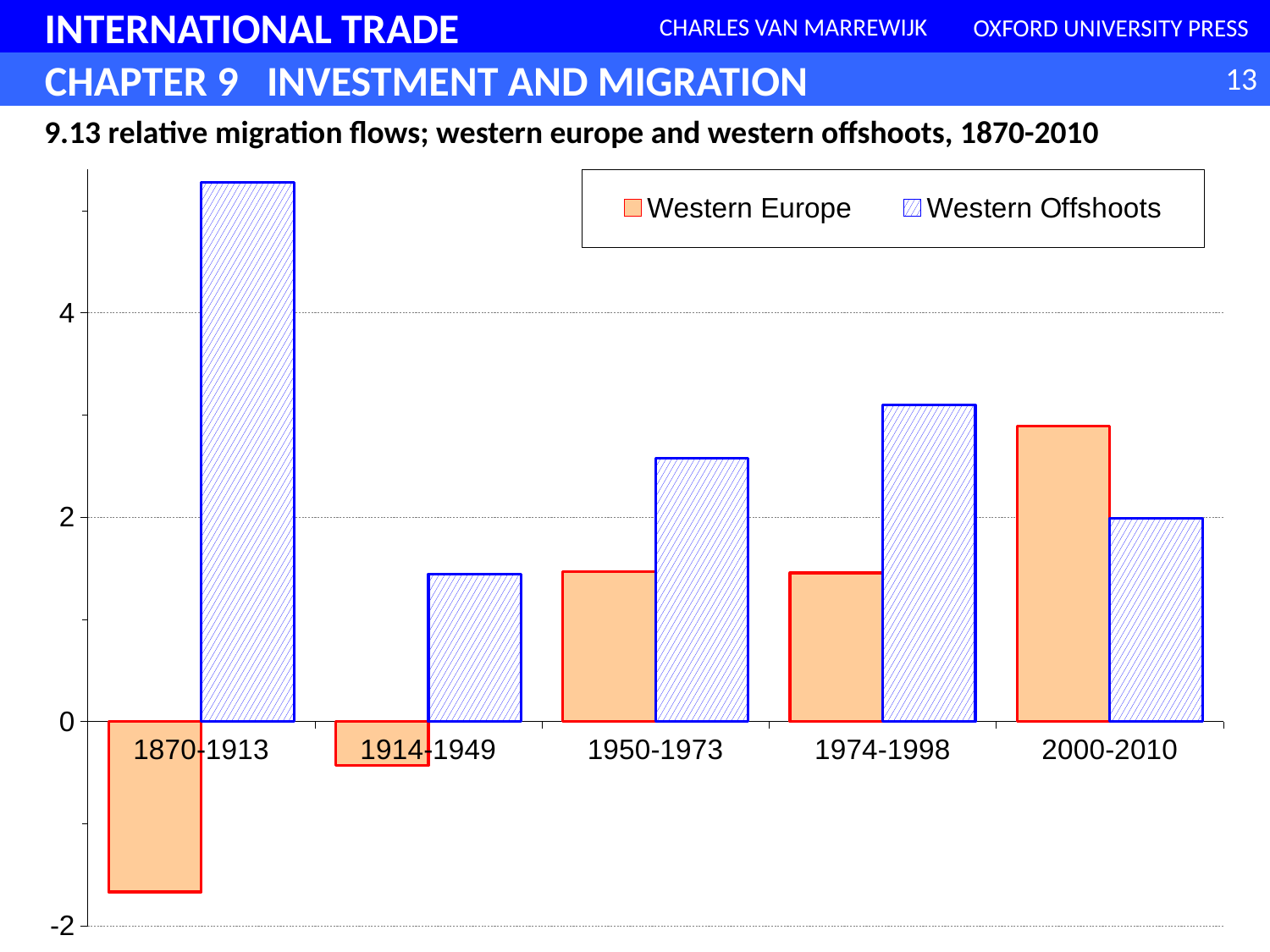
How many series does the legend list? 2 In which period is the Western Europe value lowest? 1870-1913 In which period is the Western Offshoots value highest? 1870-1913 Is the Western Europe value for 1870-1913 greater or less than 0? less What is the title of the chart? 9.13 relative migration flows; western europe and western offshoots, 1870-2010 Is the Western Offshoots value for 1974-1998 greater or less than 2? greater What kind of chart is shown on the slide? bar chart In 1870-1913, which series has the larger value, Western Europe or Western Offshoots? Western Offshoots Do the Western Europe values generally rise or fall from 1870-1913 to 2000-2010? rise In 2000-2010, which series has the larger value, Western Europe or Western Offshoots? Western Europe How many time periods are shown on the x axis? 5 Is the Western Offshoots value for 1870-1913 greater or less than 4? greater